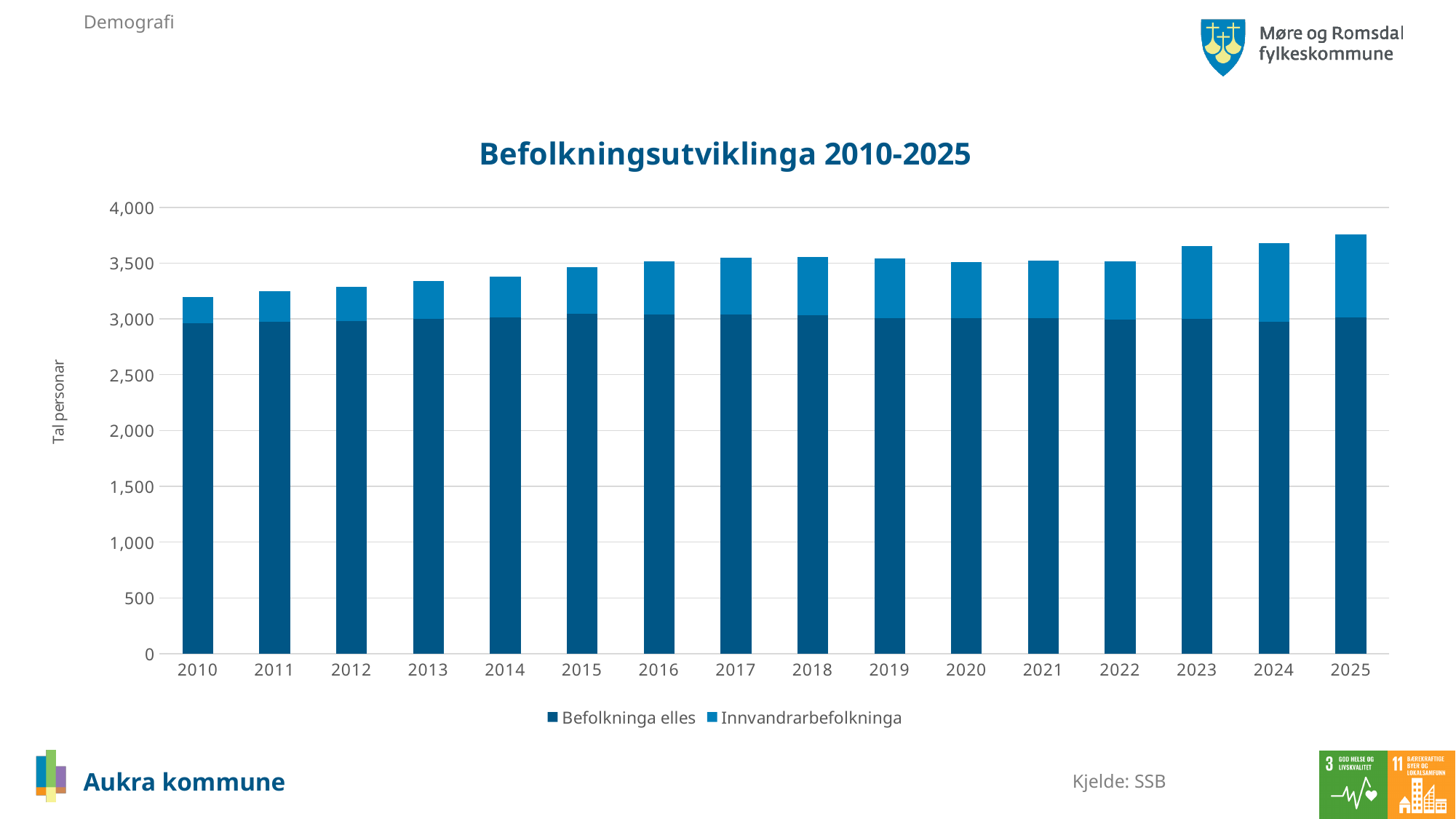
What is the title of the chart? Befolkningsutviklinga 2010-2025 Which two series are listed in the legend? Befolkninga elles and Innvandrarbefolkninga Do the total bars generally rise or fall from 2010 to 2025? rise Is the total bar for 2025 greater or less than 3,500? greater Which year has the larger total bar, 2016 or 2023? 2023 What kind of chart is shown on the slide? Stacked bar chart Which year has the highest total bar? 2025 How many series does the legend list? 2 How many years are shown on the x axis? 16 Is the total bar for 2010 greater or less than 3,500? less Which year has the lowest total bar? 2010